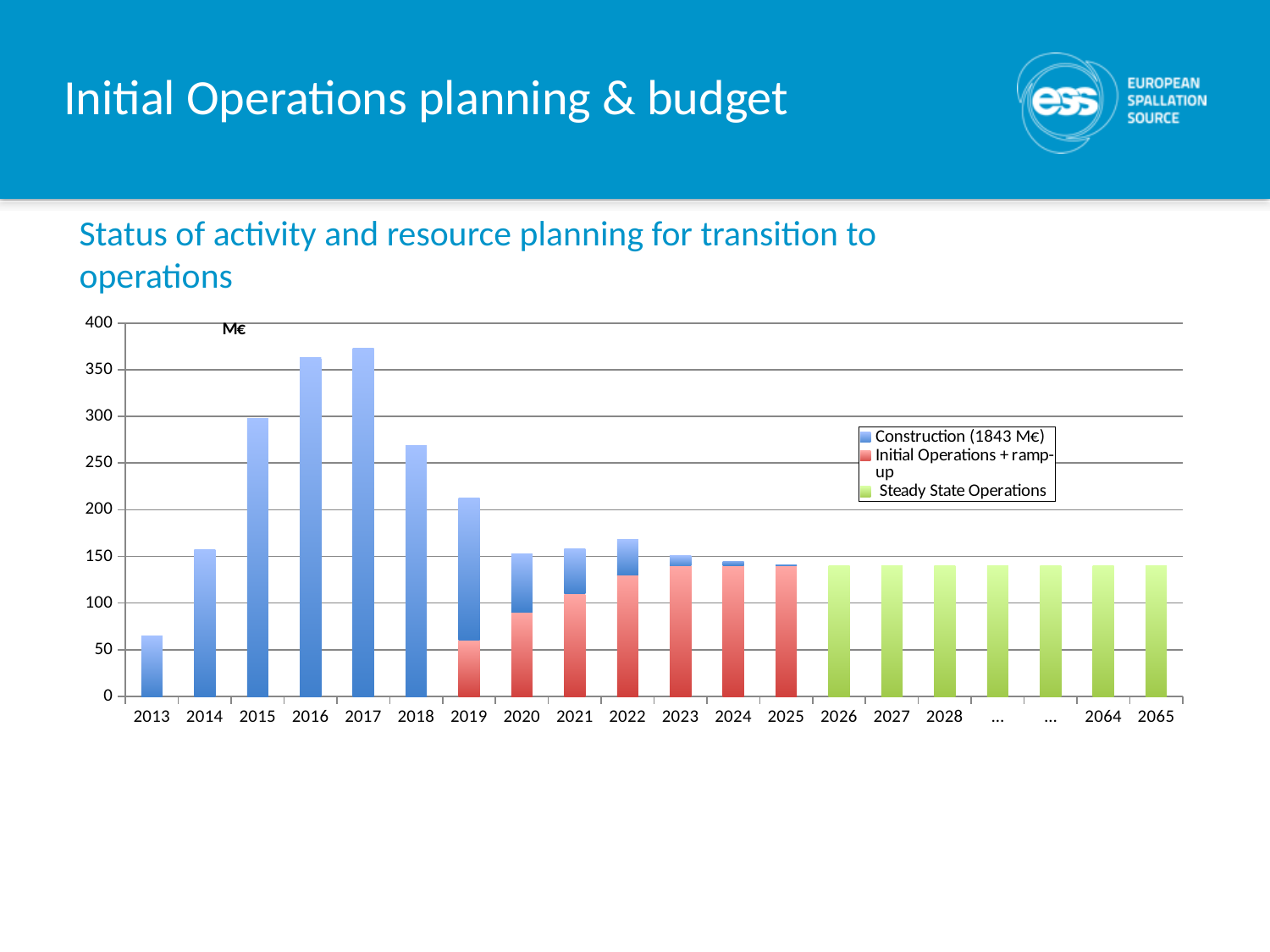
What kind of chart is shown on the slide? bar chart Is the value for 2017 greater or less than 350? greater How many categories are shown along the x axis? 20 How many series does the legend list? 3 Is the value for 2026 greater or less than 150? less What total amount is given in the legend entry for Construction? 1843 M€ Do the bar values rise or fall from 2013 to 2017? rise Which year has the lowest total bar? 2013 Is the value for 2013 greater or less than 50? greater Which is larger, the bar for 2015 or the bar for 2018? 2015 Which year has the highest total bar? 2017